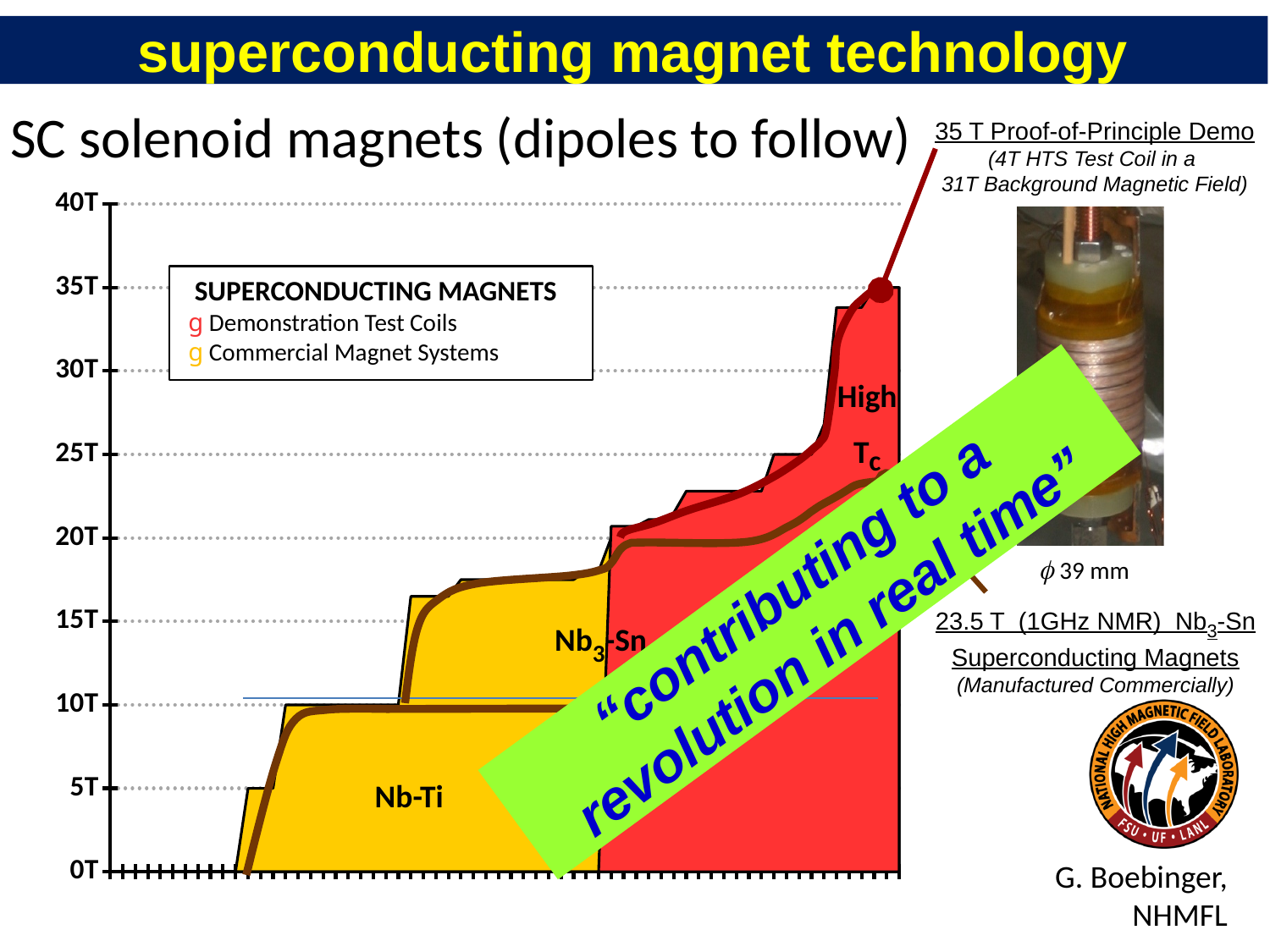
Is the peak value of the High Tc region greater or less than 30T? greater How many series does the chart legend list? 2 What is the highest value shown on the chart's vertical axis? 40T Do the magnetic field values rise or fall moving left to right along the x axis? rise What field value is annotated for the commercially manufactured Nb3-Sn (1GHz NMR) superconducting magnets? 23.5 T Which labelled material region has the lowest magnetic field plateau on the chart? Nb-Ti What kind of chart is shown on the slide? area chart What field value is annotated for the Proof-of-Principle Demo at the top of the chart? 35 T Which labelled material region reaches the highest magnetic field on the chart? High Tc How many superconducting material regions are labelled on the chart? 3 What are the two series named in the chart legend? Demonstration Test Coils; Commercial Magnet Systems Is the plateau value for the Nb3-Sn region greater or less than 15T? greater